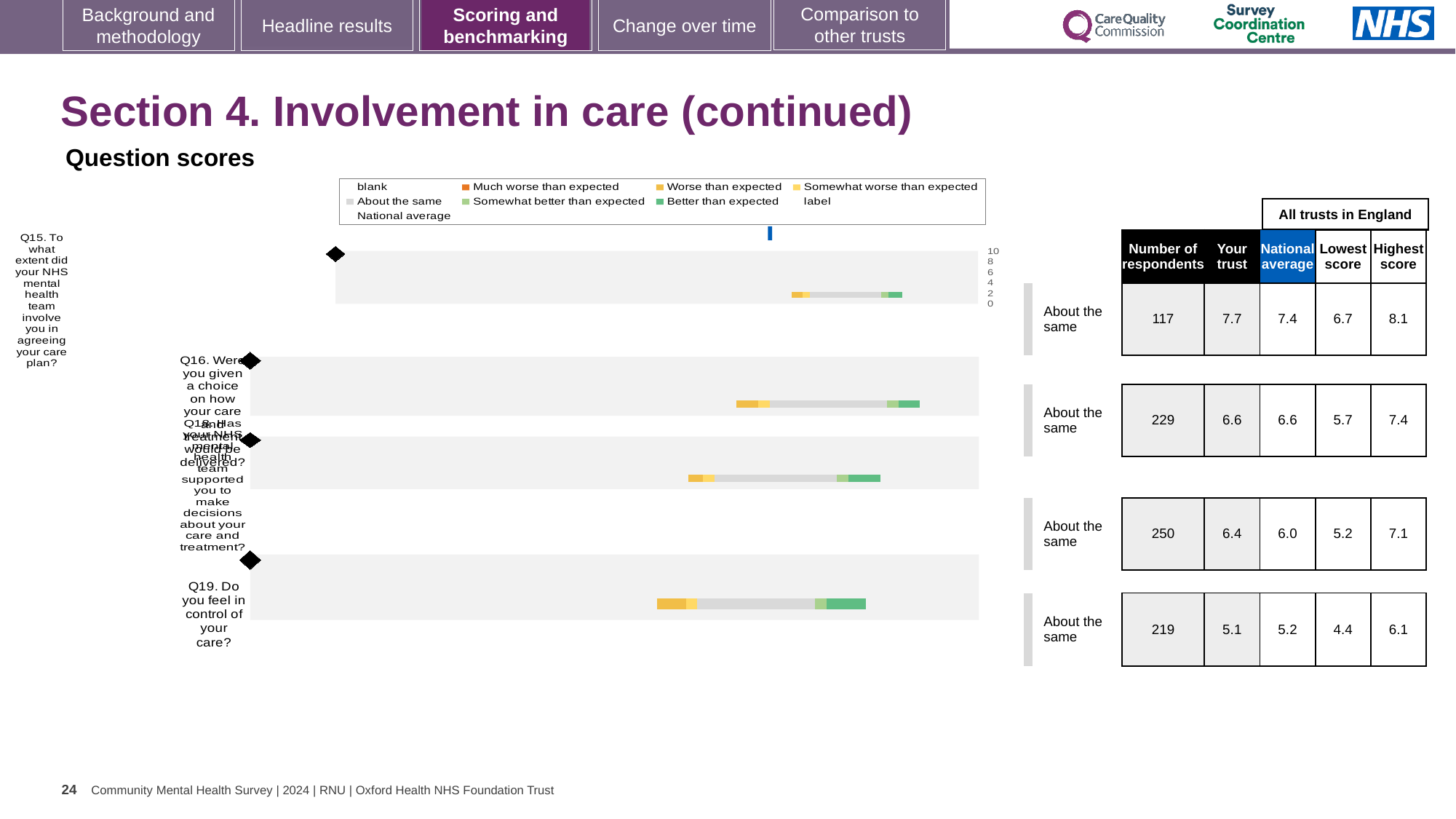
For Q15, what is the difference between the highest score and the lowest score among all trusts in England? 1.4 For Q18, which is larger: the 'Your trust' score or the national average? Your trust What benchmark category label is shown for Q16 (given a choice on how care and treatment would be delivered)? About the same How many questions are plotted in the question scores chart? 4 Which question has the highest 'Your trust' score? Q15 What kind of chart is used to show the question scores on this slide? bar chart What is the 'Your trust' score for Q15 (involving you in agreeing your care plan)? 7.7 Which question has the lowest 'Your trust' score? Q19 What is the heading above the National average, Lowest score and Highest score columns? All trusts in England What is the lowest score among all trusts in England for Q19? 4.4 What is the national average score for Q19 (feeling in control of your care)? 5.2 How many respondents answered Q18 (supported to make decisions about care and treatment)? 250